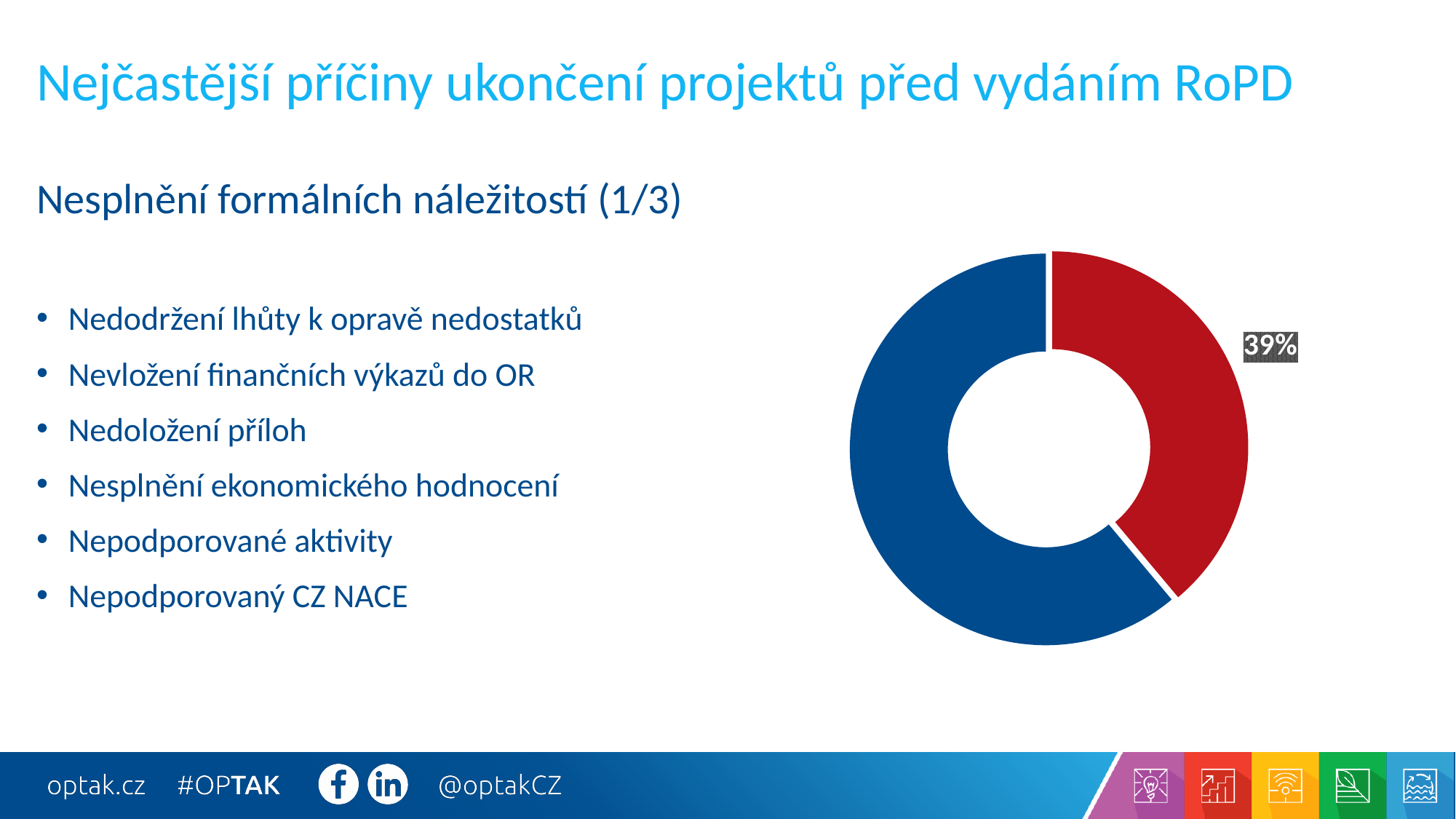
Which slice of the donut chart carries the 39% data label? The red slice What kind of chart is shown on the slide? Donut (pie) chart Which slice of the donut chart is larger, the red one or the blue one? The blue one Is the red slice of the donut chart greater or less than 50% of the chart? less How many slices does the donut chart have? 2 How many data labels are printed on the donut chart? 1 What value is printed on the red slice of the donut chart? 39% Which colour slice takes up the smallest share of the donut chart? Red Which colour slice takes up the largest share of the donut chart? Blue Is the blue slice of the donut chart greater or less than 50% of the chart? greater